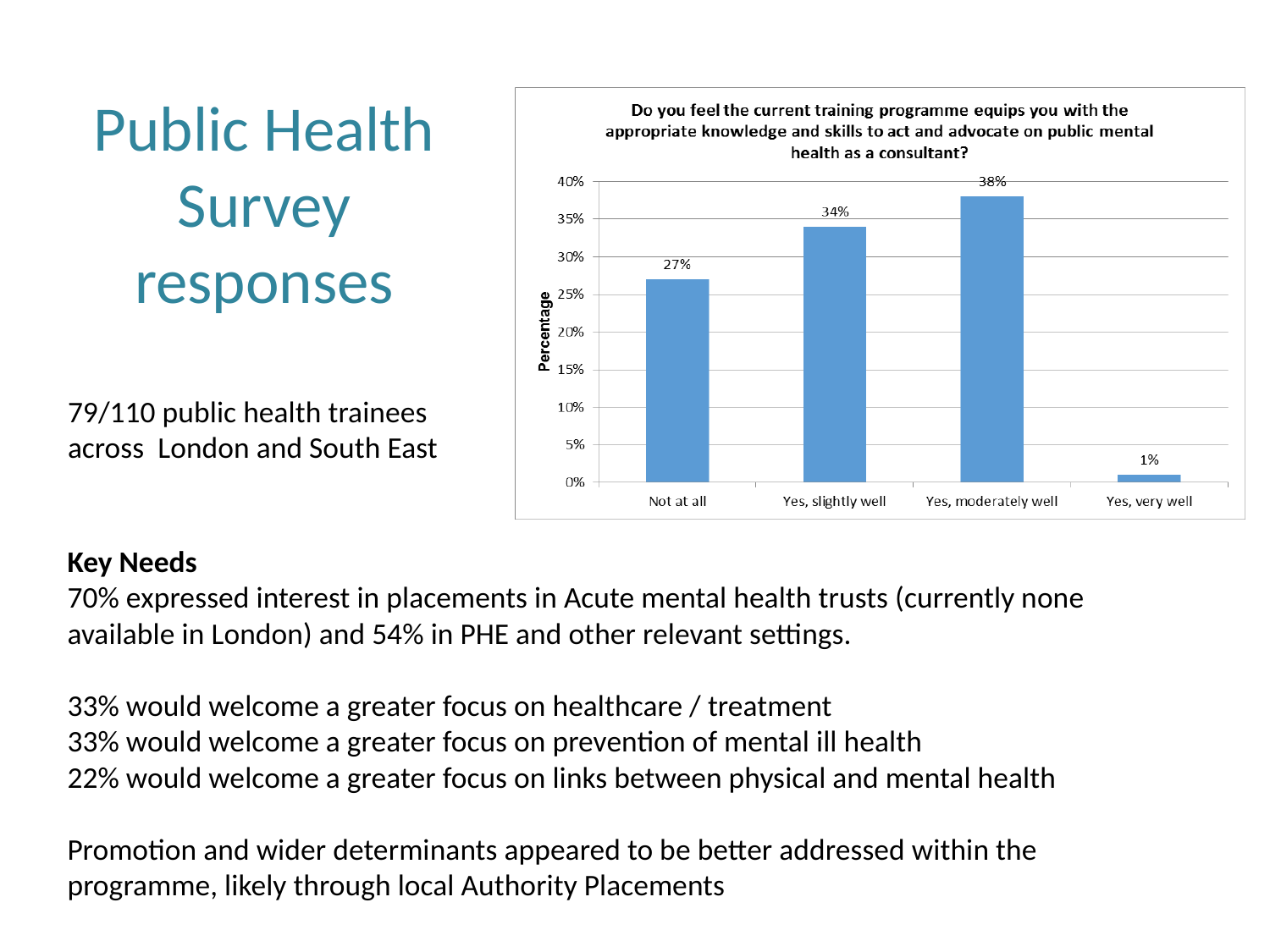
What percentage of respondents answered "Not at all"? 27% Which is larger, the percentage for "Yes, slightly well" or for "Not at all"? Yes, slightly well Which response category has the highest percentage? Yes, moderately well What is the label of the y axis of the chart? Percentage What percentage of respondents answered "Yes, moderately well"? 38% What is the difference in percentage points between "Yes, moderately well" and "Not at all"? 11 Which response category has the lowest percentage? Yes, very well What percentage of respondents answered "Yes, very well"? 1% Is the value for "Yes, slightly well" greater or less than 30%? greater What kind of chart is shown on the slide? Bar chart How many response categories are shown on the x axis? 4 What is the difference in percentage points between "Yes, slightly well" and "Yes, very well"? 33